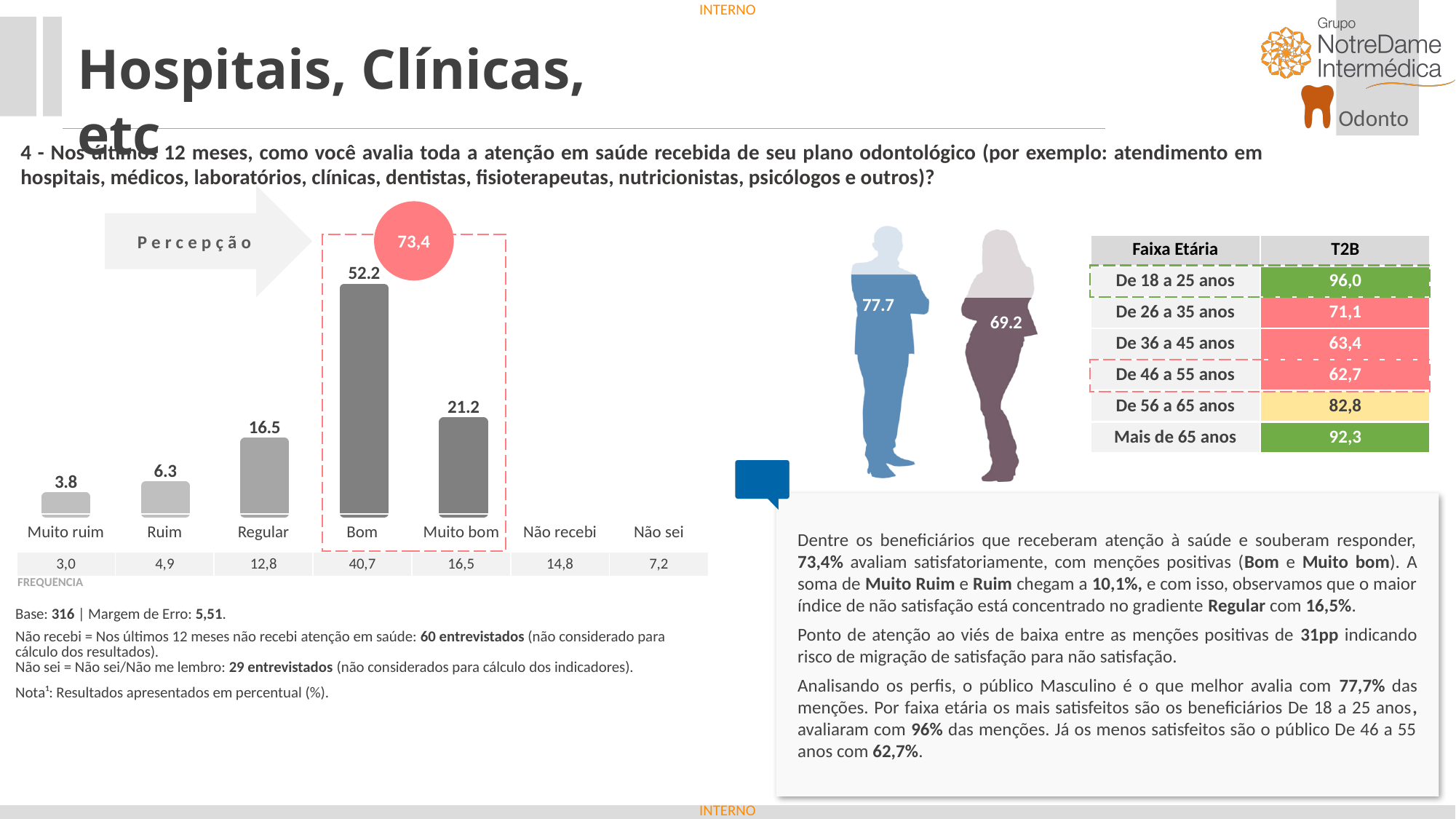
What is the value shown for the 'Regular' bar in the bar chart? 16.5 What value is shown in the pink circle above the dashed box around 'Bom' and 'Muito bom'? 73,4 In the 'Faixa Etária' table, what is the T2B value for 'De 18 a 25 anos'? 96,0 What is the difference between the 'Bom' and 'Muito bom' values in the bar chart? 31 Which category has the lowest bar in the bar chart? Muito ruim What type of chart is used to show the perception results on the left of the slide? Bar chart What is the value shown for the 'Bom' bar in the bar chart? 52.2 In the 'Faixa Etária' table, which age group has the lowest T2B value? De 46 a 55 anos Which category has the highest bar in the bar chart? Bom What is the value shown for the 'Muito bom' bar in the bar chart? 21.2 What is the value shown for the 'Muito ruim' bar in the bar chart? 3.8 Which is larger in the bar chart, the value for 'Ruim' or the value for 'Regular'? Regular